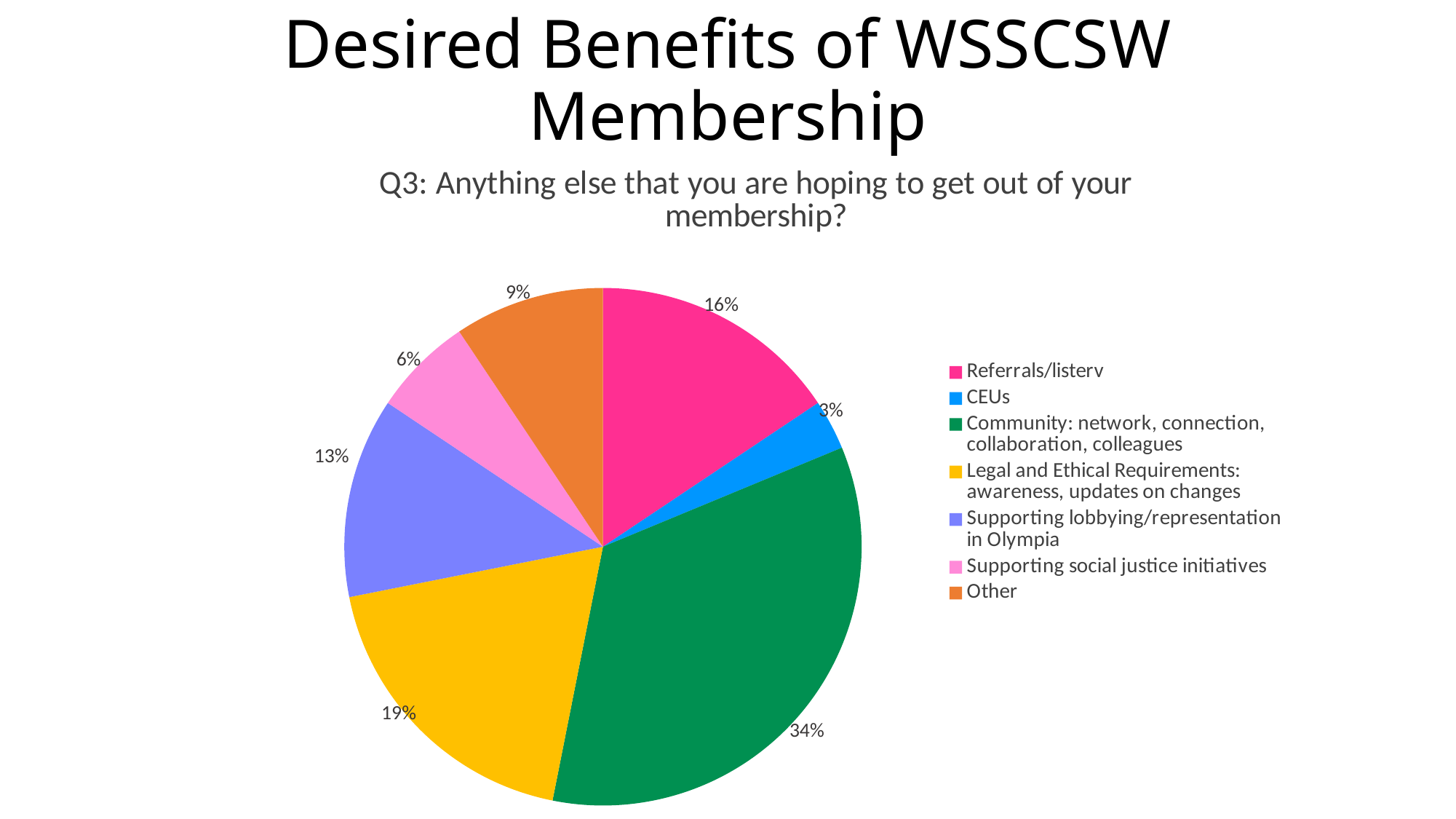
What percentage is shown for Supporting lobbying/representation in Olympia? 13% How many categories does the legend list? 7 Which is larger, the slice for Other or the slice for Supporting social justice initiatives? Other What is the difference in percentage points between Community and Legal and Ethical Requirements? 15 What percentage of the pie is CEUs? 3% What percentage is shown for Supporting social justice initiatives? 6% What type of chart is shown on the slide? pie chart Which category has the smallest slice of the pie? CEUs What share of the pie does Community: network, connection, collaboration, colleagues have? 34% What percentage is shown for Legal and Ethical Requirements: awareness, updates on changes? 19% What percentage of the pie is Referrals/listerv? 16% Which category has the largest slice of the pie? Community: network, connection, collaboration, colleagues